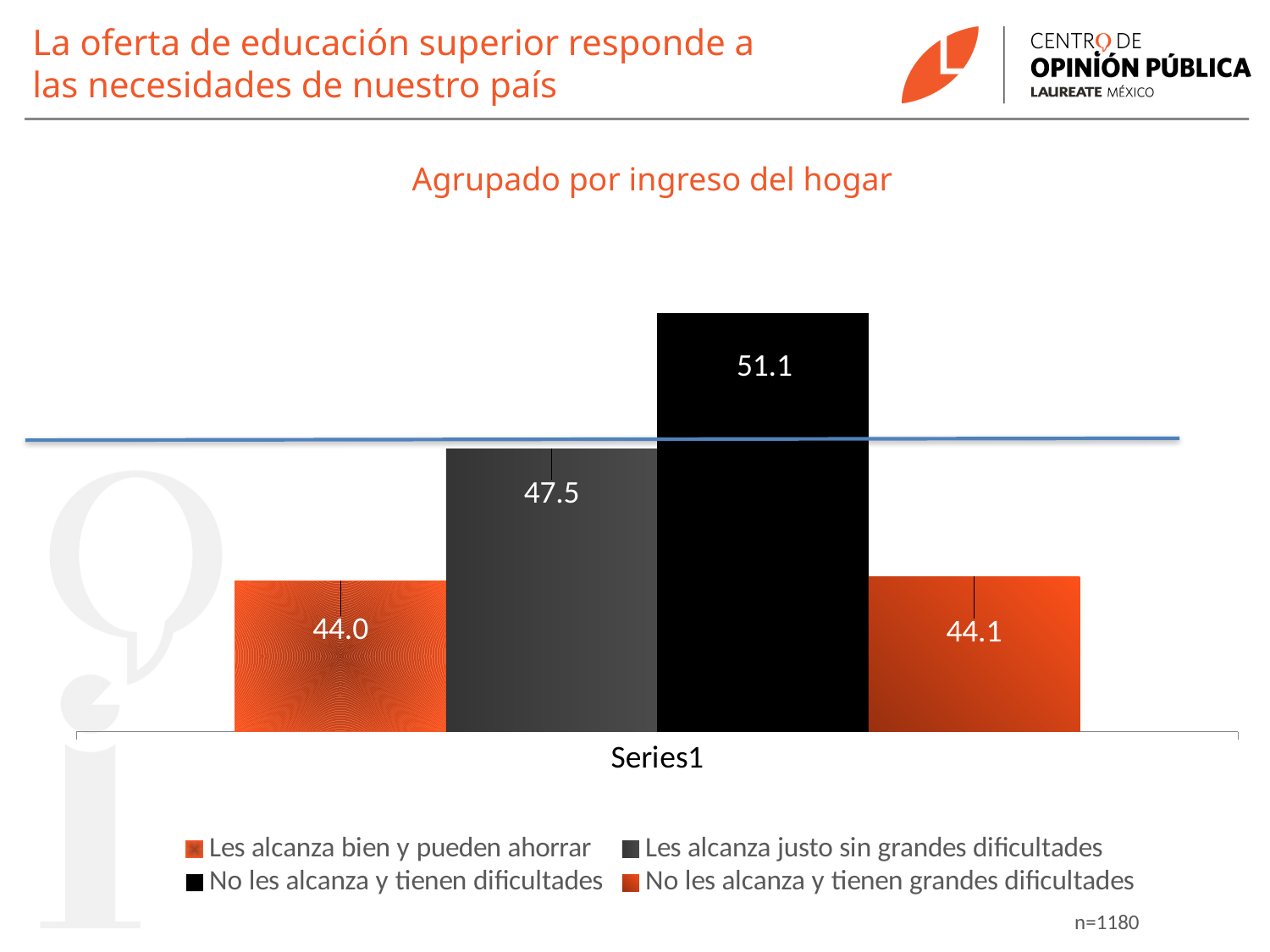
What is the value for 'Les alcanza justo sin grandes dificultades'? 47.5 What is the difference between the values for 'No les alcanza y tienen dificultades' and 'Les alcanza justo sin grandes dificultades'? 3.6 How many series does the legend list? 4 What is the value for 'No les alcanza y tienen grandes dificultades'? 44.1 Which is larger, the value for 'Les alcanza justo sin grandes dificultades' or the value for 'Les alcanza bien y pueden ahorrar'? Les alcanza justo sin grandes dificultades What is the title of the chart? Agrupado por ingreso del hogar What is the difference between the values for 'Les alcanza justo sin grandes dificultades' and 'Les alcanza bien y pueden ahorrar'? 3.5 Which is larger, the value for 'No les alcanza y tienen dificultades' or the value for 'No les alcanza y tienen grandes dificultades'? No les alcanza y tienen dificultades Which group has the highest value? No les alcanza y tienen dificultades What kind of chart is shown on the slide? Bar chart What is the value for 'No les alcanza y tienen dificultades'? 51.1 What is the value for 'Les alcanza bien y pueden ahorrar'? 44.0